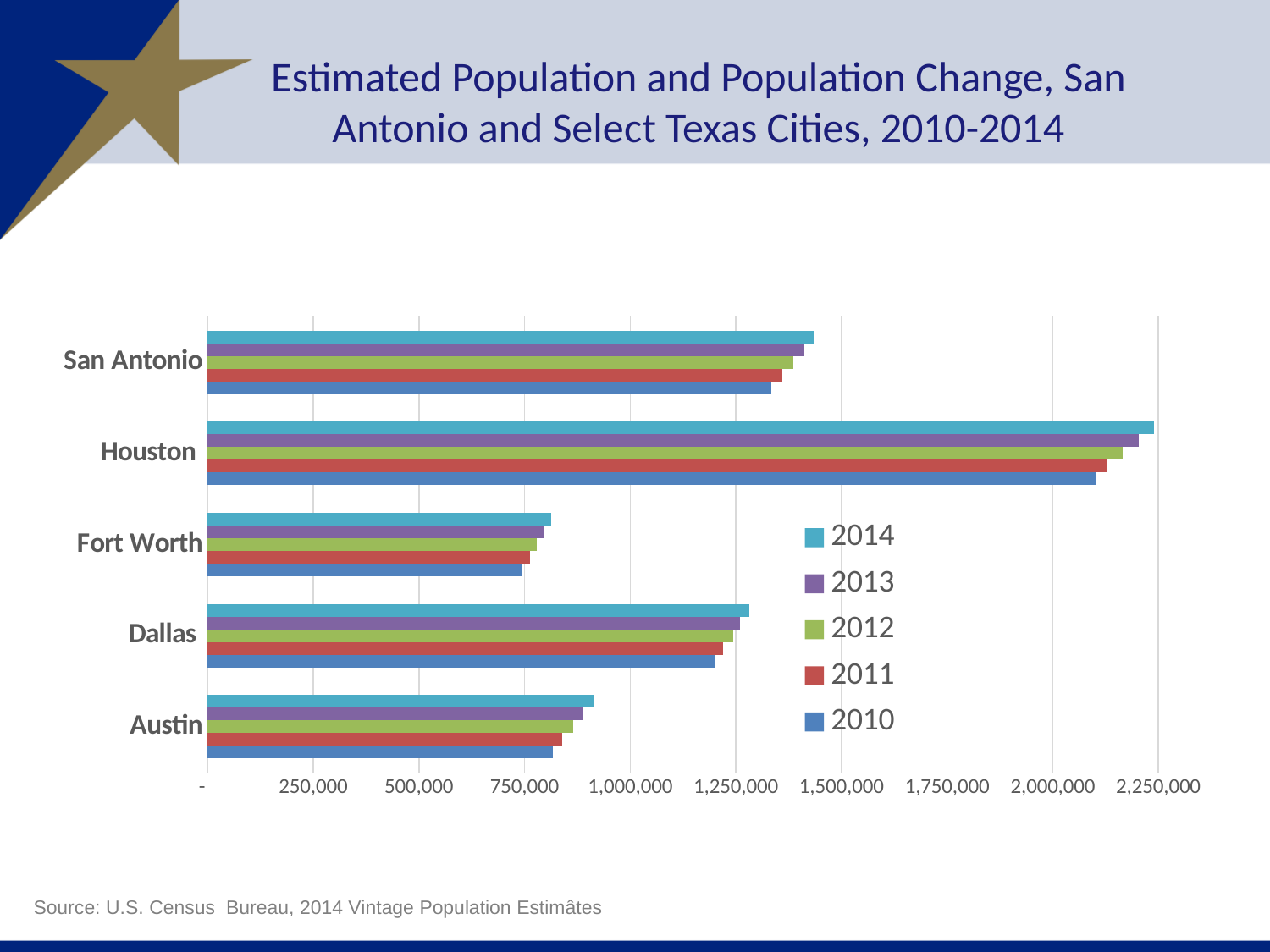
Is the 2014 value for Fort Worth greater or less than 750,000? greater Is the 2010 value for San Antonio greater or less than 1,250,000? greater Which is larger, the 2014 value for San Antonio or the 2014 value for Dallas? San Antonio What kind of chart is shown on the slide? Bar chart Which city has the highest estimated population in 2014? Houston Which year does the legend list first (at the top)? 2014 Which city has the lowest estimated population in 2014? Fort Worth How many cities are shown on the chart? 5 From 2010 to 2014, does the estimated population for Austin rise or fall? Rise How many series does the legend list? 5 Is the 2014 value for Austin greater or less than 1,000,000? less